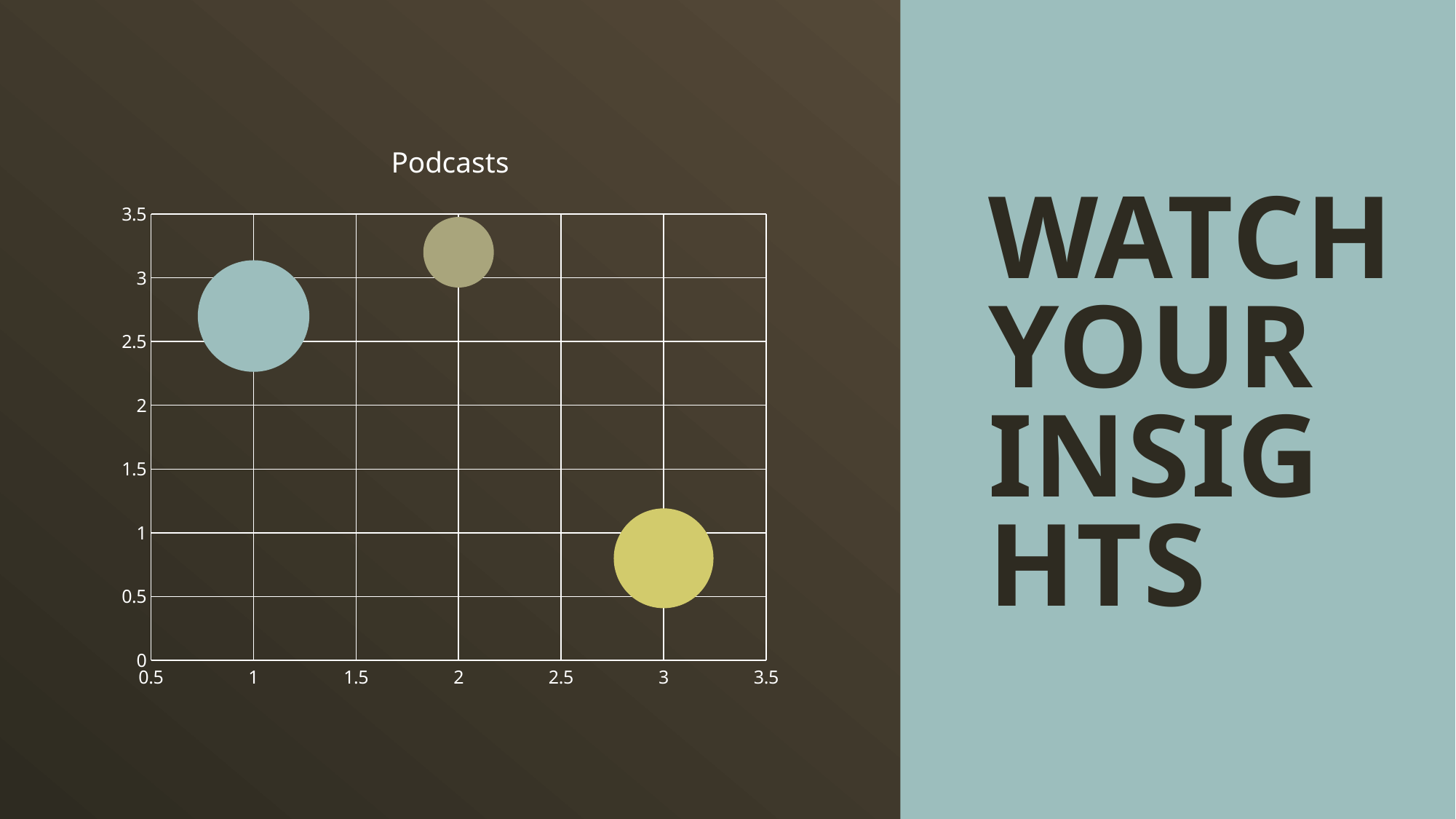
How many bubbles are plotted on the chart? 3 What is the x value of the largest bubble on the chart? 1 Is the y value of the bubble at x = 1 greater or less than 2.5? greater What is the x value of the smallest bubble on the chart? 2 Which bubble has the lowest y value: the one at x = 1, x = 2, or x = 3? x = 3 What is the title of the chart? Podcasts Which bubble has the highest y value: the one at x = 1, x = 2, or x = 3? x = 2 What is the maximum value shown on the y axis? 3.5 Is the y value of the bubble at x = 3 greater or less than 1? less Is the y value of the bubble at x = 2 greater or less than 3? greater What kind of chart is shown on the slide? bubble chart Which bubble has a larger y value, the one at x = 1 or the one at x = 3? x = 1